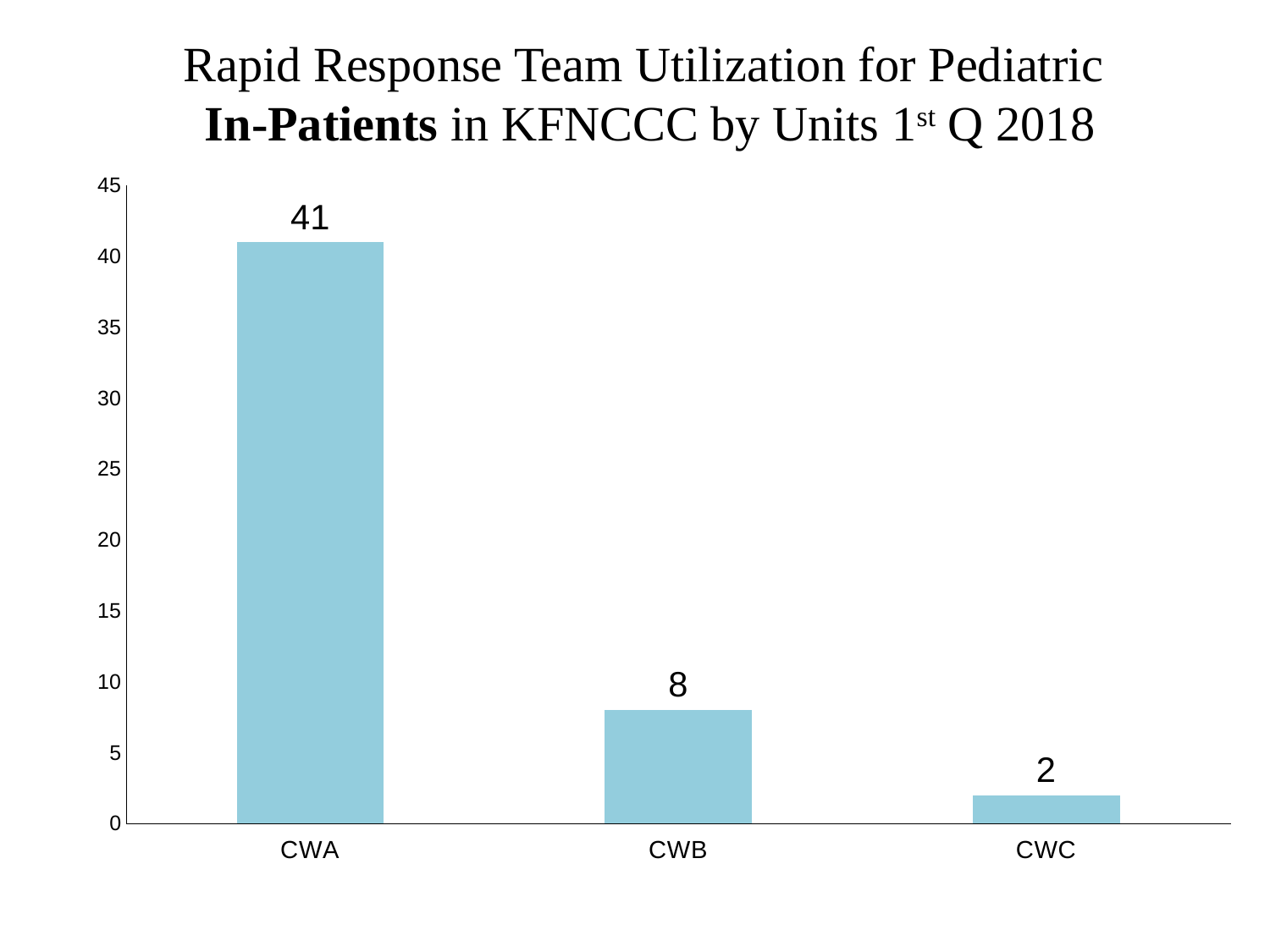
How many units are shown on the x axis? 3 Which unit has the highest value? CWA What is the value for CWC? 2 What is the value for CWB? 8 What kind of chart is shown on the slide? bar chart What is the difference between the values for CWA and CWB? 33 What is the difference between the values for CWB and CWC? 6 Which is larger, the value for CWB or the value for CWC? CWB Do the values rise or fall from CWA to CWC along the x axis? fall Is the value for CWA greater or less than 40? greater What is the value for CWA? 41 Which unit has the lowest value? CWC